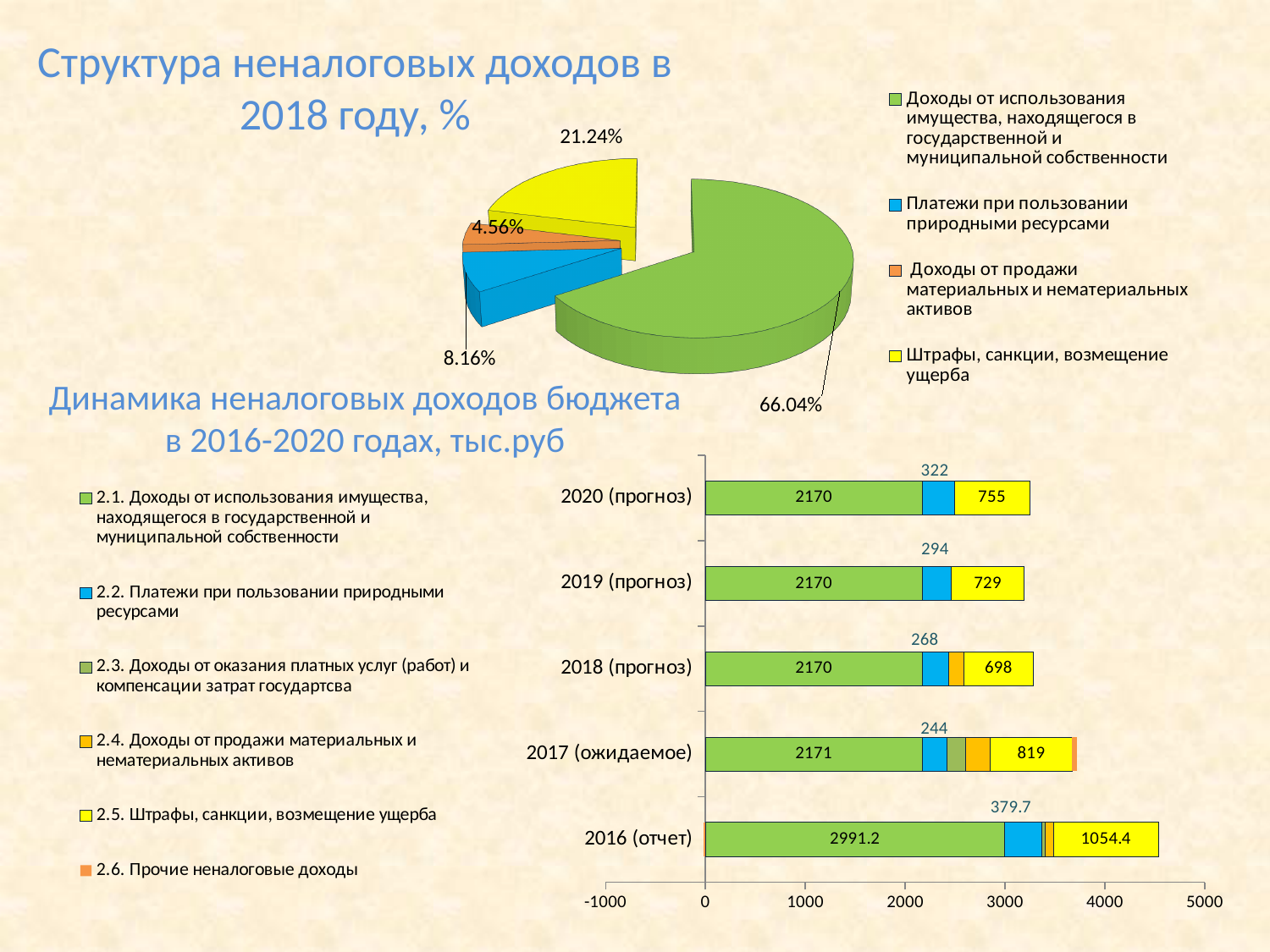
In the bar chart 'Динамика неналоговых доходов бюджета в 2016-2020 годах, тыс.руб', how many series does the legend list? 6 In the pie chart 'Структура неналоговых доходов в 2018 году, %', which category has the smallest share? Доходы от продажи материальных и нематериальных активов In the pie chart 'Структура неналоговых доходов в 2018 году, %', what share is shown for 'Платежи при пользовании природными ресурсами'? 8.16% In the bar chart 'Динамика неналоговых доходов бюджета в 2016-2020 годах, тыс.руб', which year has the highest value for '2.2. Платежи при пользовании природными ресурсами'? 2016 (отчет) What kind of chart is 'Динамика неналоговых доходов бюджета в 2016-2020 годах, тыс.руб'? Stacked bar chart In the pie chart 'Структура неналоговых доходов в 2018 году, %', what share is shown for 'Штрафы, санкции, возмещение ущерба'? 21.24% In the bar chart 'Динамика неналоговых доходов бюджета в 2016-2020 годах, тыс.руб', what is the value of '2.1. Доходы от использования имущества...' for 2016 (отчет)? 2991.2 In the bar chart 'Динамика неналоговых доходов бюджета в 2016-2020 годах, тыс.руб', what is the value of '2.5. Штрафы, санкции, возмещение ущерба' for 2019 (прогноз)? 729 In the pie chart 'Структура неналоговых доходов в 2018 году, %', which category has the largest share? Доходы от использования имущества, находящегося в государственной и муниципальной собственности In the bar chart 'Динамика неналоговых доходов бюджета в 2016-2020 годах, тыс.руб', what is the value of '2.2. Платежи при пользовании природными ресурсами' for 2017 (ожидаемое)? 244 How many slices does the pie chart 'Структура неналоговых доходов в 2018 году, %' have? 4 In the bar chart 'Динамика неналоговых доходов бюджета в 2016-2020 годах, тыс.руб', what is the difference between the '2.5. Штрафы, санкции, возмещение ущерба' values for 2020 (прогноз) and 2018 (прогноз)? 57